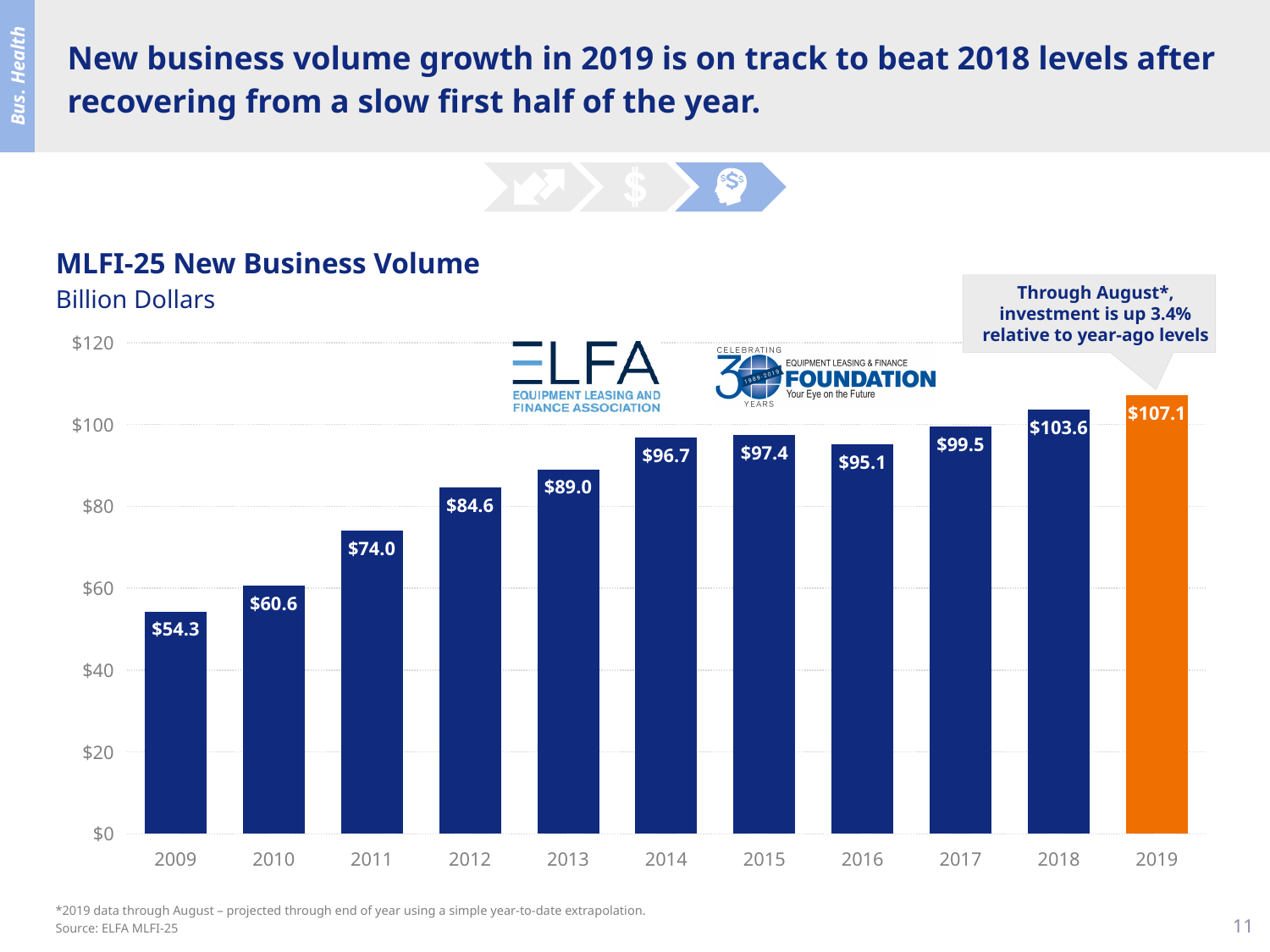
What is the MLFI-25 new business volume for 2019? $107.1 Between 2009 and 2014, do the new business volume values rise or fall? Rise Which year has the lowest MLFI-25 new business volume? 2009 Which year has a larger new business volume, 2015 or 2016? 2015 What kind of chart is used to show MLFI-25 New Business Volume? Bar chart Which year's bar is coloured orange instead of blue? 2019 What is the MLFI-25 new business volume for 2011? $74.0 What is the MLFI-25 new business volume for 2014? $96.7 Which year has the highest MLFI-25 new business volume? 2019 How many years are shown on the x axis of the chart? 11 Is the value for 2012 greater or less than $80? greater What is the difference between the 2018 and 2017 new business volumes? $4.1